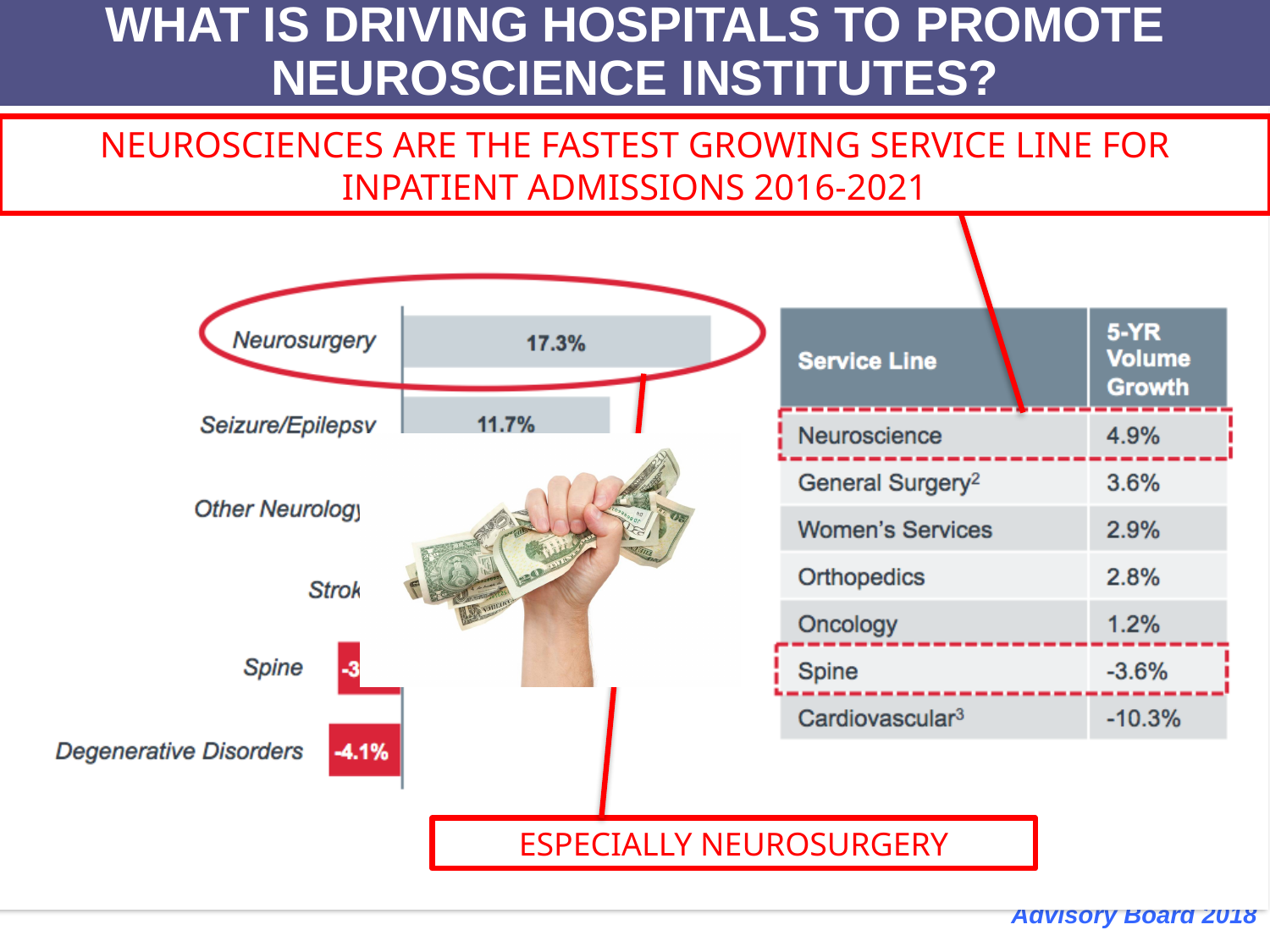
In the bar chart on the left, what is the value shown for Degenerative Disorders? -4.1% How many categories are listed in the bar chart on the left? 6 In the bar chart on the left, what is the value shown for Neurosurgery? 17.3% In the bar chart on the left, which category has the lowest value? Degenerative Disorders In the table on the right, which service line has the lowest 5-YR Volume Growth? Cardiovascular In the bar chart on the left, what colour are the bars with negative values? Red In the bar chart on the left, what is the difference between the Neurosurgery value and the Seizure/Epilepsy value? 5.6 percentage points In the bar chart on the left, which is larger, the value for Neurosurgery or the value for Seizure/Epilepsy? Neurosurgery In the bar chart on the left, what is the value shown for Seizure/Epilepsy? 11.7% In the table on the right, what is the 5-YR Volume Growth for Neuroscience? 4.9% In the bar chart on the left, which category has the highest value? Neurosurgery What kind of chart is shown on the left of the slide? Bar chart